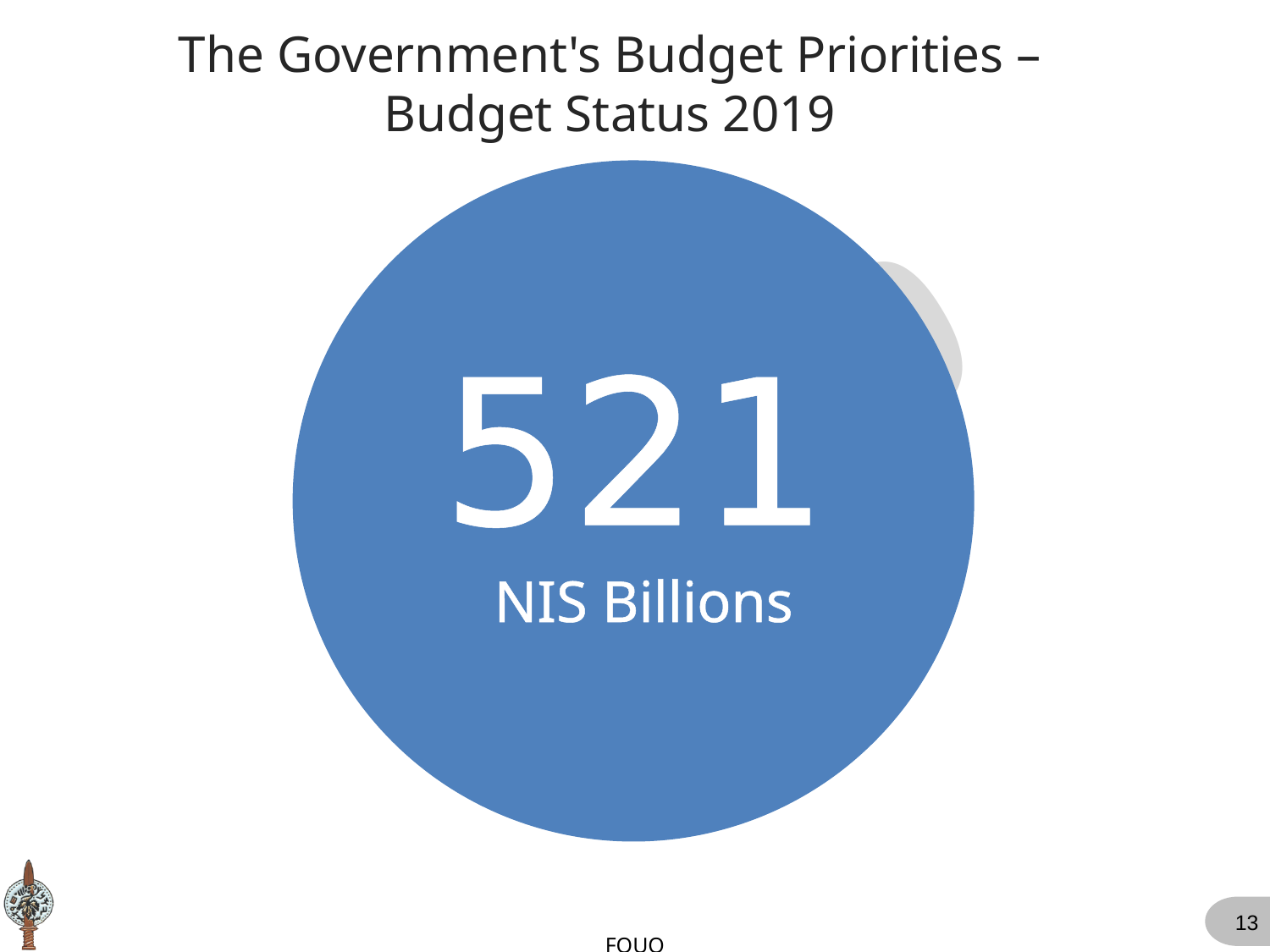
What is the title of the slide containing the chart? The Government's Budget Priorities – Budget Status 2019 Is the value shown in the chart greater or less than 500? greater Which year does the budget status shown in the chart refer to? 2019 What unit is shown beneath the number 521 in the chart? NIS Billions What total value is displayed in the centre of the chart? 521